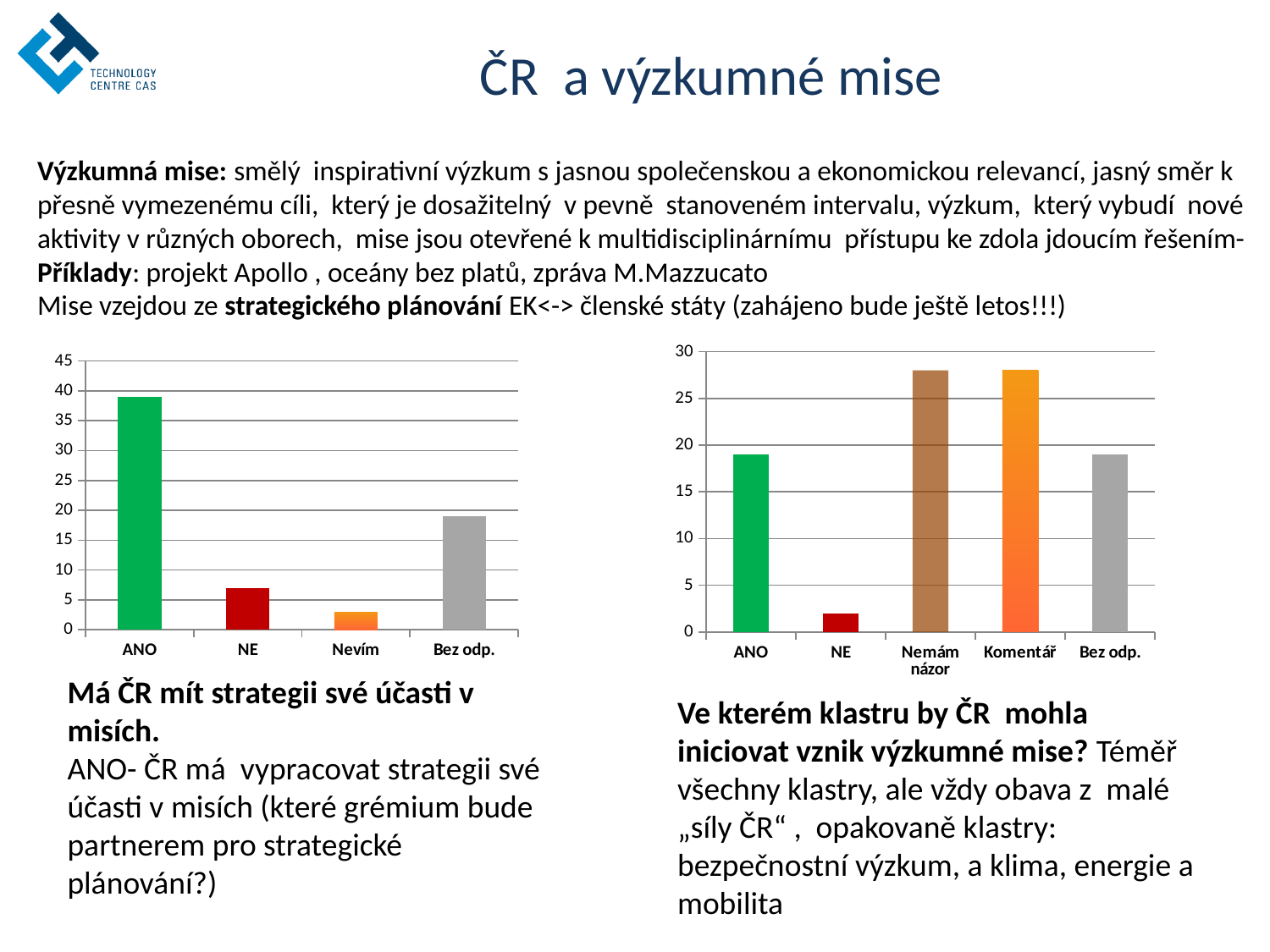
What type of chart is the left chart on the slide? bar chart In the left chart, which category has the lowest value? Nevím In the left chart, which is larger, the value for Bez odp. or the value for NE? Bez odp. How many categories are shown in the right chart? 5 In the left chart, is the value for NE greater or less than 10? less In the left chart, is the value for ANO greater or less than 35? greater In the right chart, which category has the lowest value? NE How many categories are shown in the left chart? 4 In the right chart, is the value for NE greater or less than 5? less In the left chart, which category has the highest value? ANO In the right chart, which is larger, the value for Nemám názor or the value for ANO? Nemám názor